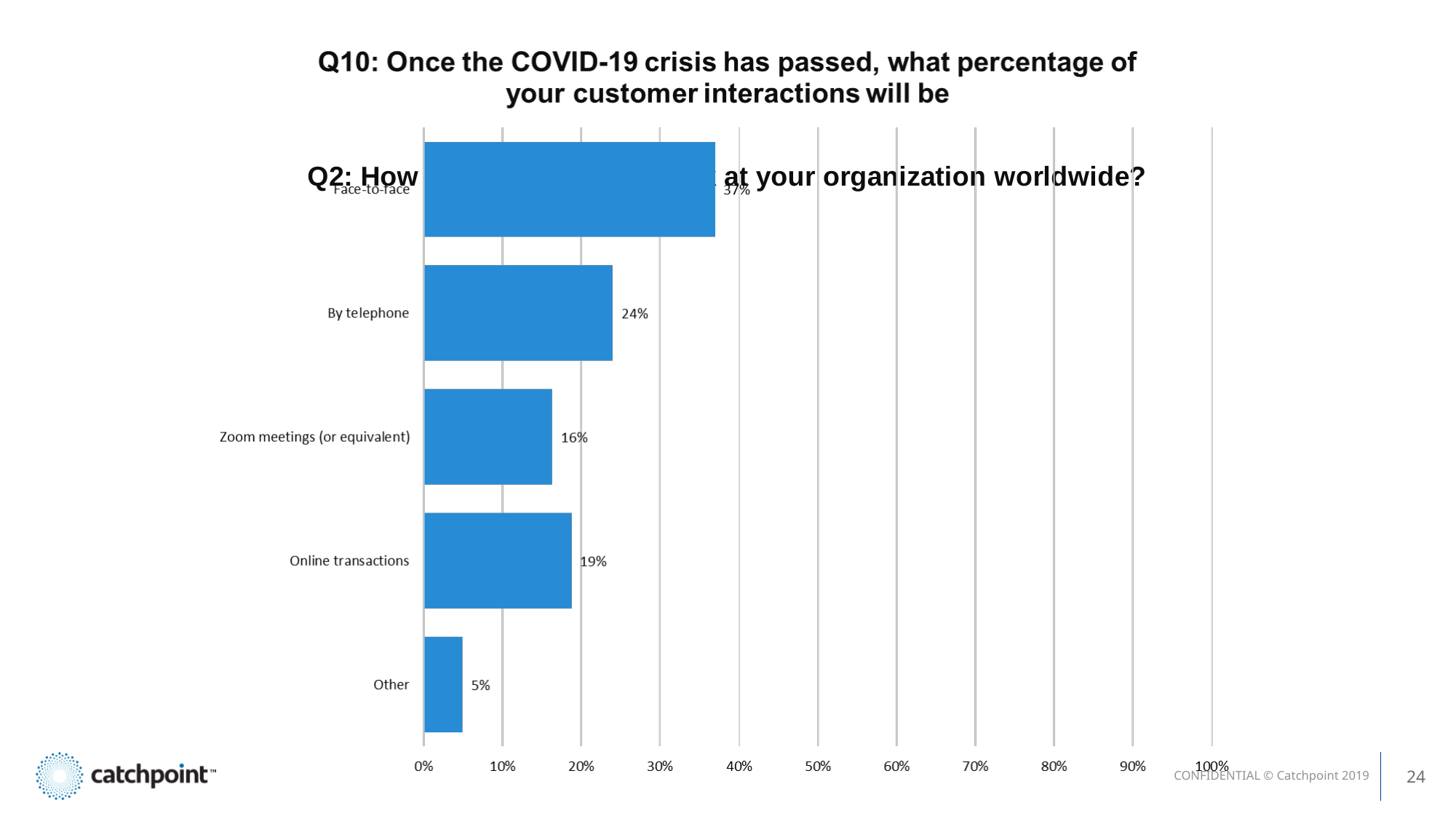
What percentage is shown for Zoom meetings (or equivalent)? 16% What kind of chart is shown on the slide? bar chart What percentage is shown for By telephone? 24% What is the highest value labelled on the x axis? 100% What percentage is shown for Online transactions? 19% What is the difference between the values for By telephone and Online transactions? 5% Is the value for Face-to-face greater or less than 30%? greater What percentage is shown for Other? 5% Which category has the highest value? Face-to-face Which is larger, the value for Online transactions or the value for Zoom meetings (or equivalent)? Online transactions Which category has the lowest value? Other How many categories are shown in the chart? 5